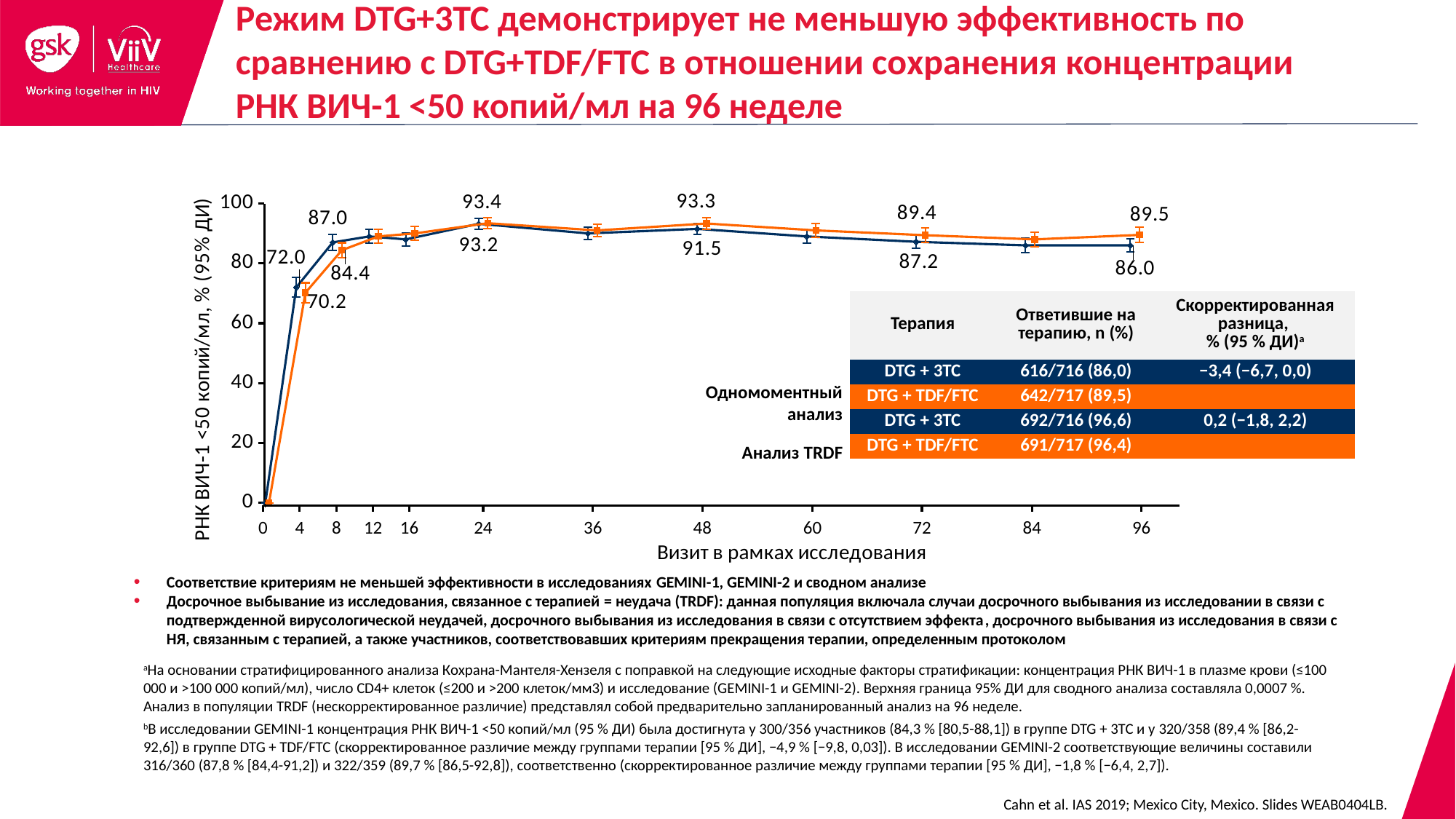
What is the labelled value for DTG + 3TC at week 48? 91.5 What is the labelled value for DTG + 3TC at week 4? 72.0 What kind of chart is shown on the slide? Line chart Is the value for DTG + 3TC at week 12 greater or less than 80? greater What is the difference between the DTG + TDF/FTC and DTG + 3TC labelled values at week 96? 3.5 What is the title of the x axis? Визит в рамках исследования At week 48, which treatment arm has the higher labelled value? DTG + TDF/FTC Between week 0 and week 24, does the DTG + TDF/FTC line rise or fall? rise What is the labelled value for DTG + TDF/FTC (orange line) at week 96? 89.5 What is the labelled value for DTG + 3TC (dark blue line) at week 96? 86.0 How many study visit time points are marked on the x axis? 12 What is the labelled value for DTG + TDF/FTC at week 8? 84.4